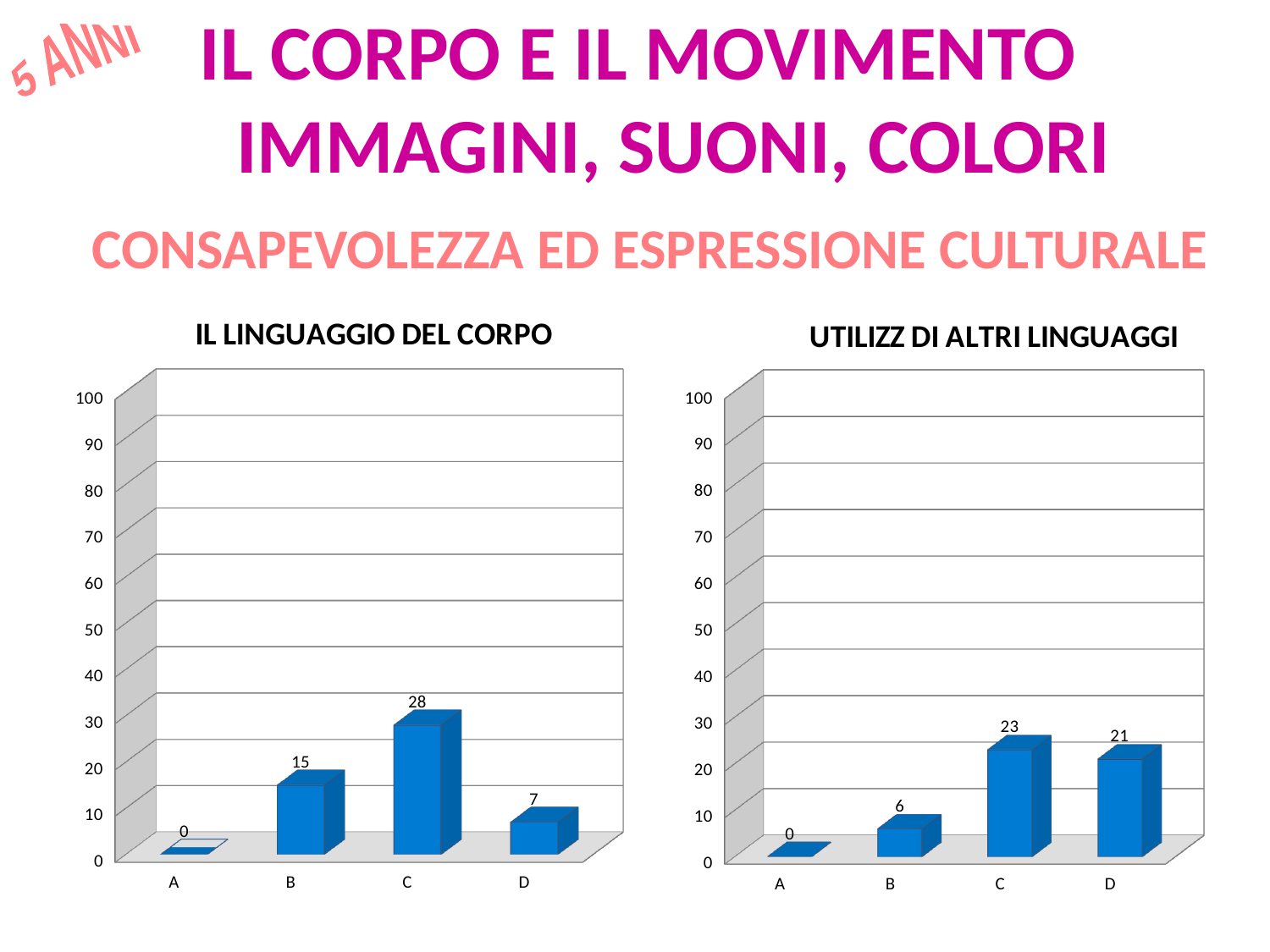
In the 'UTILIZZ DI ALTRI LINGUAGGI' chart, which category has the lowest value? A In the 'UTILIZZ DI ALTRI LINGUAGGI' chart, what is the value for category B? 6 In the 'IL LINGUAGGIO DEL CORPO' chart, what is the difference between the values for C and D? 21 How many categories are shown in the 'IL LINGUAGGIO DEL CORPO' chart? 4 In the 'IL LINGUAGGIO DEL CORPO' chart, which is larger, the value for B or the value for D? B In the 'UTILIZZ DI ALTRI LINGUAGGI' chart, what is the value for category D? 21 In the 'IL LINGUAGGIO DEL CORPO' chart, which category has the highest value? C In the 'UTILIZZ DI ALTRI LINGUAGGI' chart, is the value for C greater or less than 30? less What kind of chart is the 'UTILIZZ DI ALTRI LINGUAGGI' chart? bar chart In the 'IL LINGUAGGIO DEL CORPO' chart, what is the value for category B? 15 In the 'UTILIZZ DI ALTRI LINGUAGGI' chart, what is the difference between the values for C and B? 17 In the 'IL LINGUAGGIO DEL CORPO' chart, what is the value for category C? 28